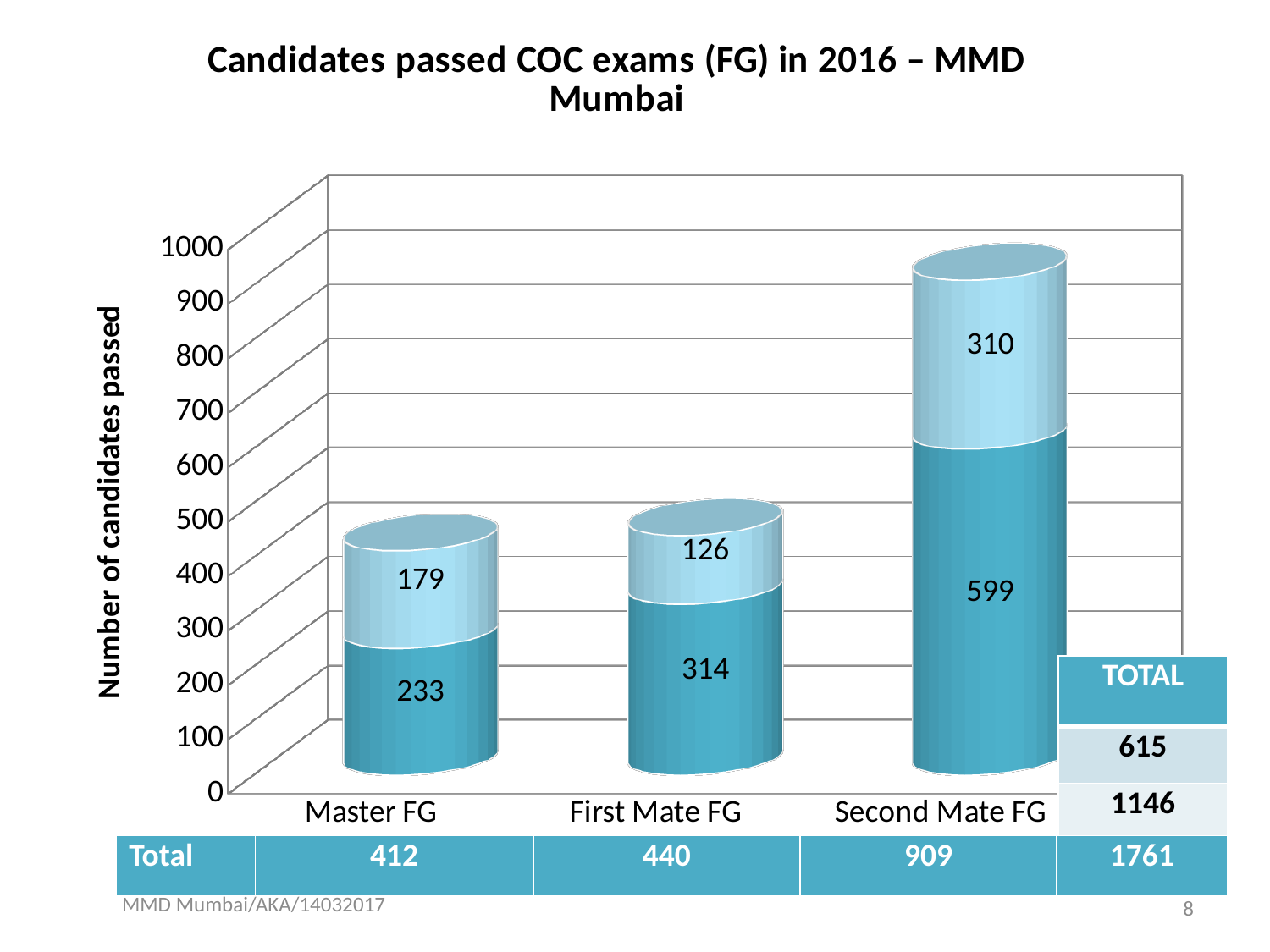
What is the difference between the darker bottom segments of Second Mate FG and Master FG? 366 Which category has the shortest stacked bar? Master FG What is the value of the darker bottom segment for Master FG? 233 What is the title of the chart? Candidates passed COC exams (FG) in 2016 – MMD Mumbai What is the label of the y axis? Number of candidates passed How many categories are shown on the x axis of the chart? 3 What kind of chart is shown on the slide? stacked bar chart Which is larger, the lighter top segment for Master FG or for First Mate FG? Master FG What is the value of the lighter top segment for Second Mate FG? 310 What is the value of the lighter top segment for First Mate FG? 126 What is the total of the stacked bar for First Mate FG? 440 Which category has the tallest stacked bar? Second Mate FG